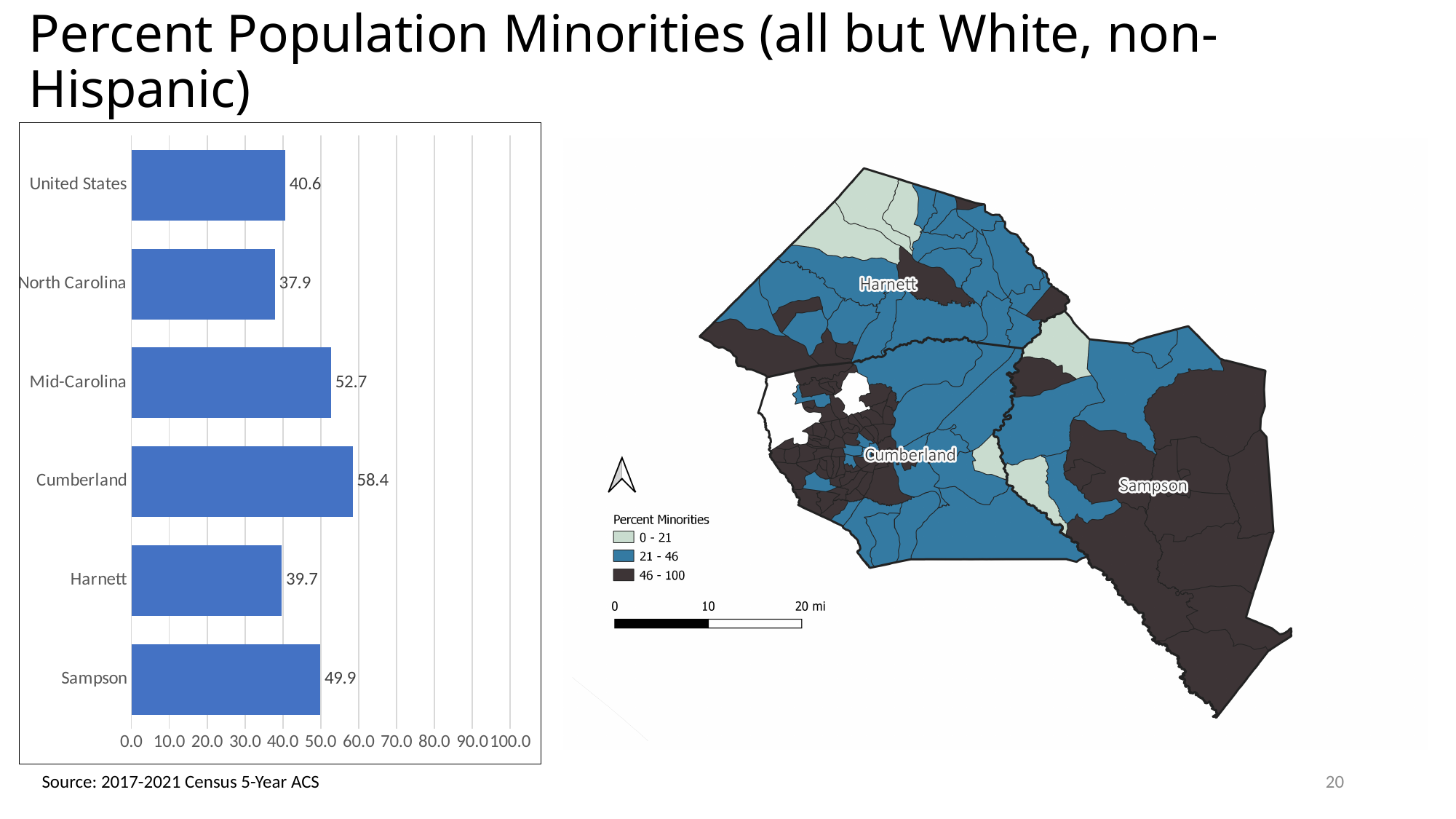
Which category has the lowest value in the bar chart? North Carolina How many categories are shown in the bar chart? 6 What is the highest value shown on the x axis of the bar chart? 100.0 Which has a larger value in the bar chart, Mid-Carolina or Sampson? Mid-Carolina Which category has the highest value in the bar chart? Cumberland What is the value for Sampson in the bar chart? 49.9 Is the value for Harnett in the bar chart greater or less than 50.0? less What is the value for North Carolina in the bar chart? 37.9 What kind of chart is shown on the left of the slide? bar chart What is the value for the United States in the bar chart? 40.6 What is the value for Cumberland in the bar chart? 58.4 What is the difference between the values for Cumberland and Harnett in the bar chart? 18.7